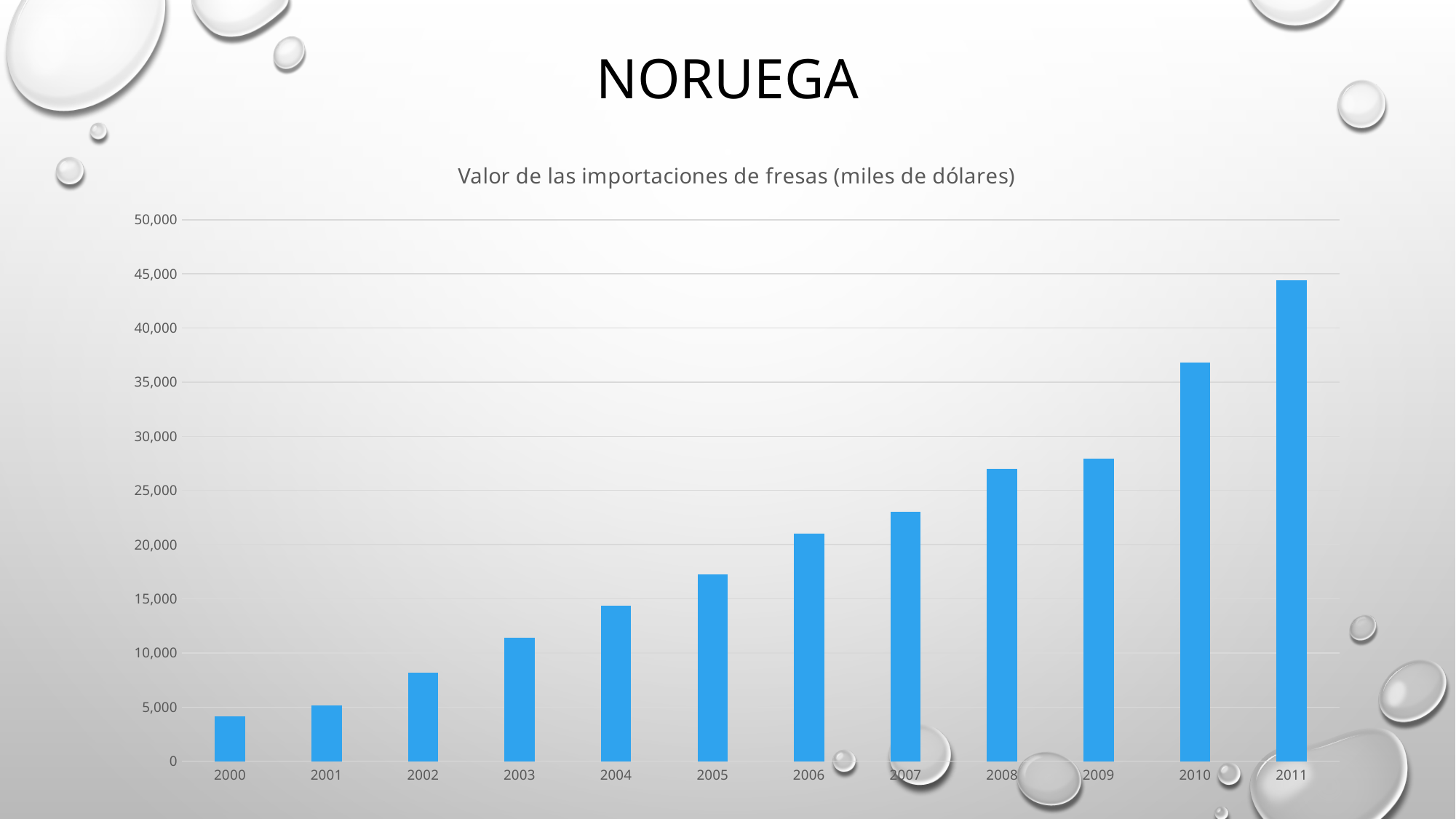
Which year has a larger value, 2009 or 2010? 2010 Which year has the lowest value of strawberry imports? 2000 Is the value for 2005 greater or less than 20,000? less What is the title of the chart? Valor de las importaciones de fresas (miles de dólares) Do the values generally rise or fall from 2000 to 2011? rise Which year has the highest value of strawberry imports? 2011 How many years are shown on the x axis of the chart? 12 Is the value for 2011 greater or less than 40,000? greater Is the value for 2010 greater or less than 35,000? greater What kind of chart is shown on the slide? bar chart